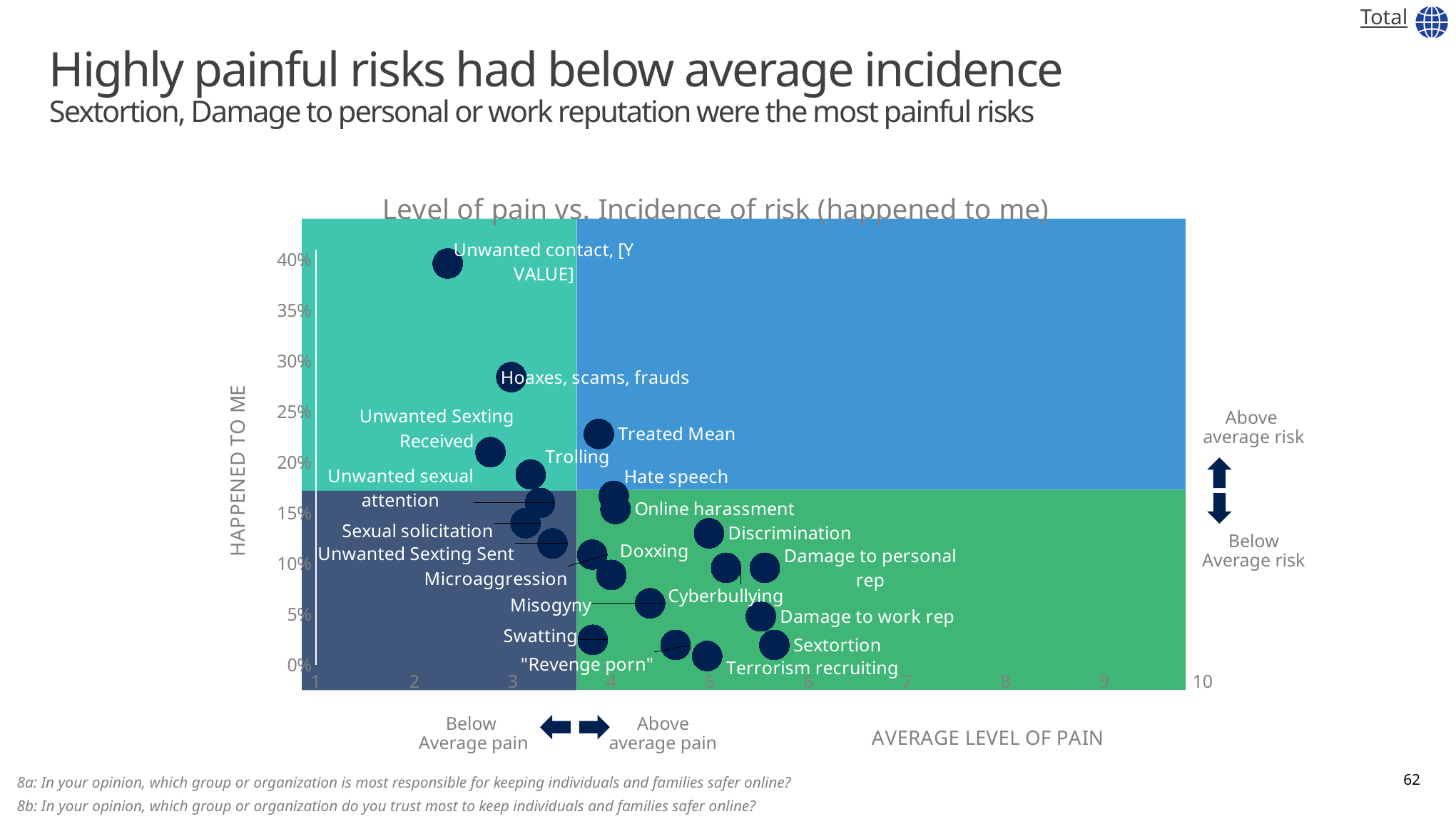
What is the title of the chart? Level of pain vs. Incidence of risk (happened to me) What is the label of the vertical axis of the chart? HAPPENED TO ME Which risk has the highest incidence ("happened to me") in the chart? Unwanted contact Is the incidence value for Hoaxes, scams, frauds greater or less than 25%? greater Which has a higher incidence, Hoaxes, scams, frauds or Treated Mean? Hoaxes, scams, frauds How many risks are plotted as points in the chart? 21 Is the incidence value for Treated Mean greater or less than 20%? greater Is the incidence value for Unwanted contact greater or less than 35%? greater What kind of chart is shown on the slide? Scatter chart Which has a higher incidence, Discrimination or Sextortion? Discrimination